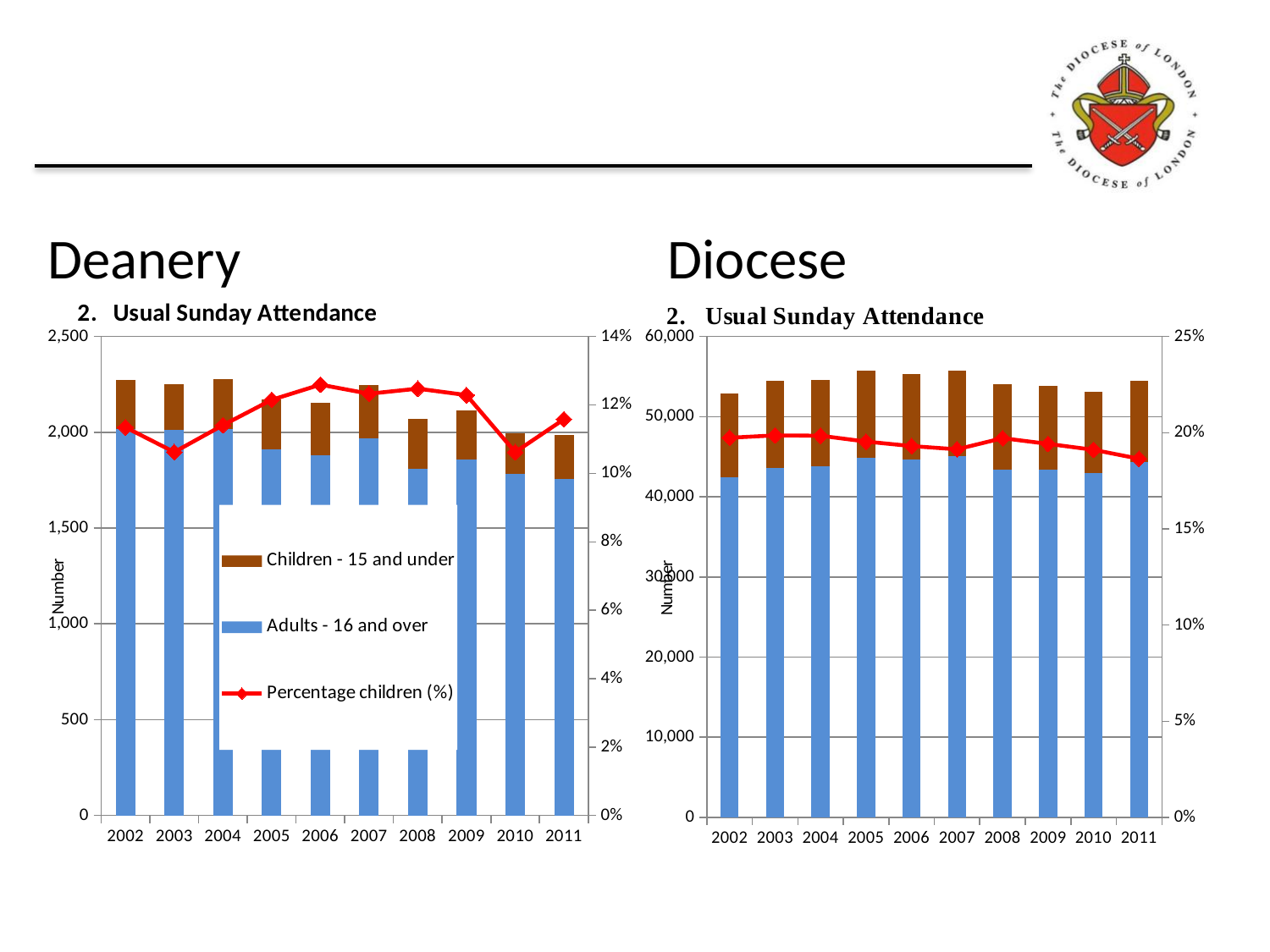
On the Deanery chart, is the Percentage children value for 2003 greater or less than 12%? less On the Deanery chart, how many series does the legend list? 3 On the Diocese chart, does the Percentage children line generally rise or fall from 2002 to 2011? fall On the Diocese chart, is the Percentage children value for 2011 greater or less than 20%? less On the Deanery chart, is the total attendance for 2002 greater or less than 2,000? greater On the Deanery chart, what are the three legend entries? Children - 15 and under; Adults - 16 and over; Percentage children (%) What kind of chart is the Diocese chart? Stacked bar chart with a line On the Diocese chart, which year has the lowest Percentage children value? 2011 On the Deanery chart, how many years are shown on the x axis? 10 On the Deanery chart, which year has the larger Adults - 16 and over value, 2002 or 2011? 2002